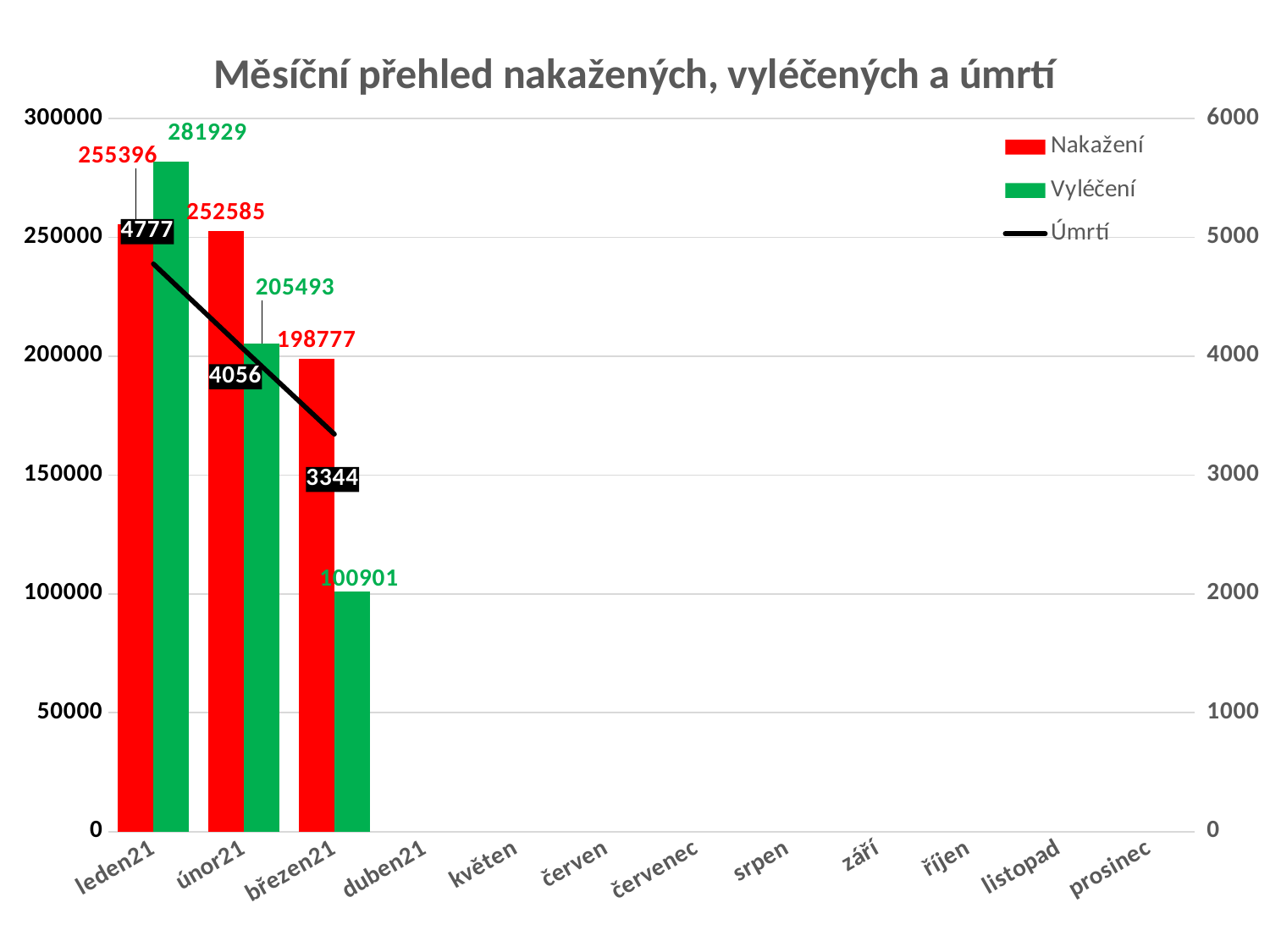
How many categories are shown on the x axis? 12 Which month has the highest Vyléčení value? leden21 Which month has the lowest Úmrtí value? březen21 What is the difference between the Úmrtí values for únor21 and březen21? 712 What is the value of Nakažení for únor21? 252585 What is the difference between the Vyléčení values for leden21 and únor21? 76436 What is the title of the chart? Měsíční přehled nakažených, vyléčených a úmrtí What is the value of Úmrtí for leden21? 4777 Which is larger for leden21, Nakažení or Vyléčení? Vyléčení What is the value of Vyléčení for březen21? 100901 How many series does the legend list? 3 Does the Úmrtí line rise or fall from leden21 to březen21? fall